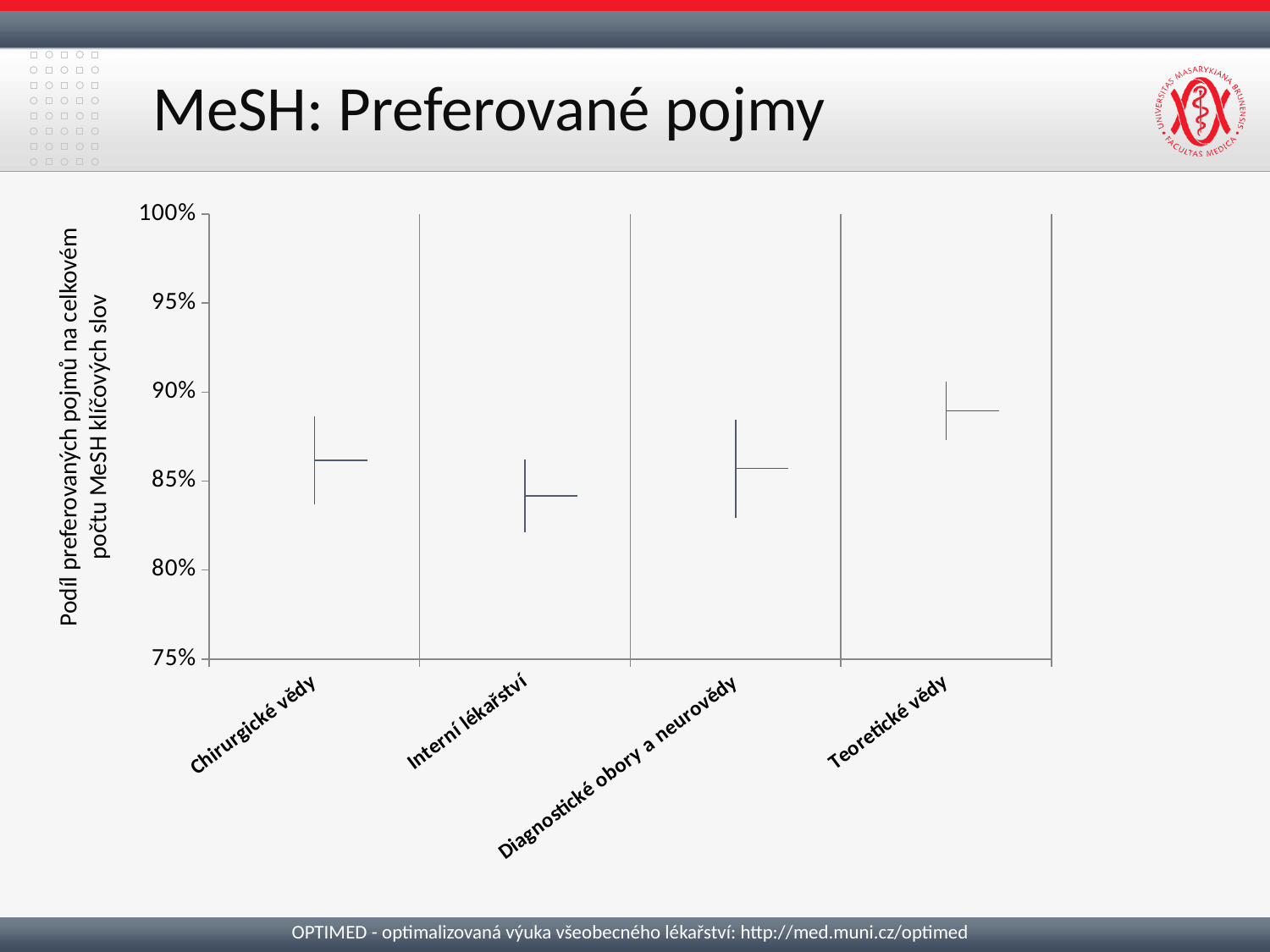
Which category has the lowest value in the chart? Interní lékařství Is the value for Teoretické vědy greater or less than 90%? less Is the value for Interní lékařství greater or less than 85%? less Is the value for Teoretické vědy greater or less than 85%? greater Which has the larger value, Chirurgické vědy or Interní lékařství? Chirurgické vědy Which category has the highest value in the chart? Teoretické vědy How many categories are shown on the x axis of the chart? 4 What is the lowest value shown on the vertical axis of the chart? 75% Which has the larger value, Teoretické vědy or Diagnostické obory a neurovědy? Teoretické vědy What is the label of the vertical axis of the chart? Podíl preferovaných pojmů na celkovém počtu MeSH klíčových slov